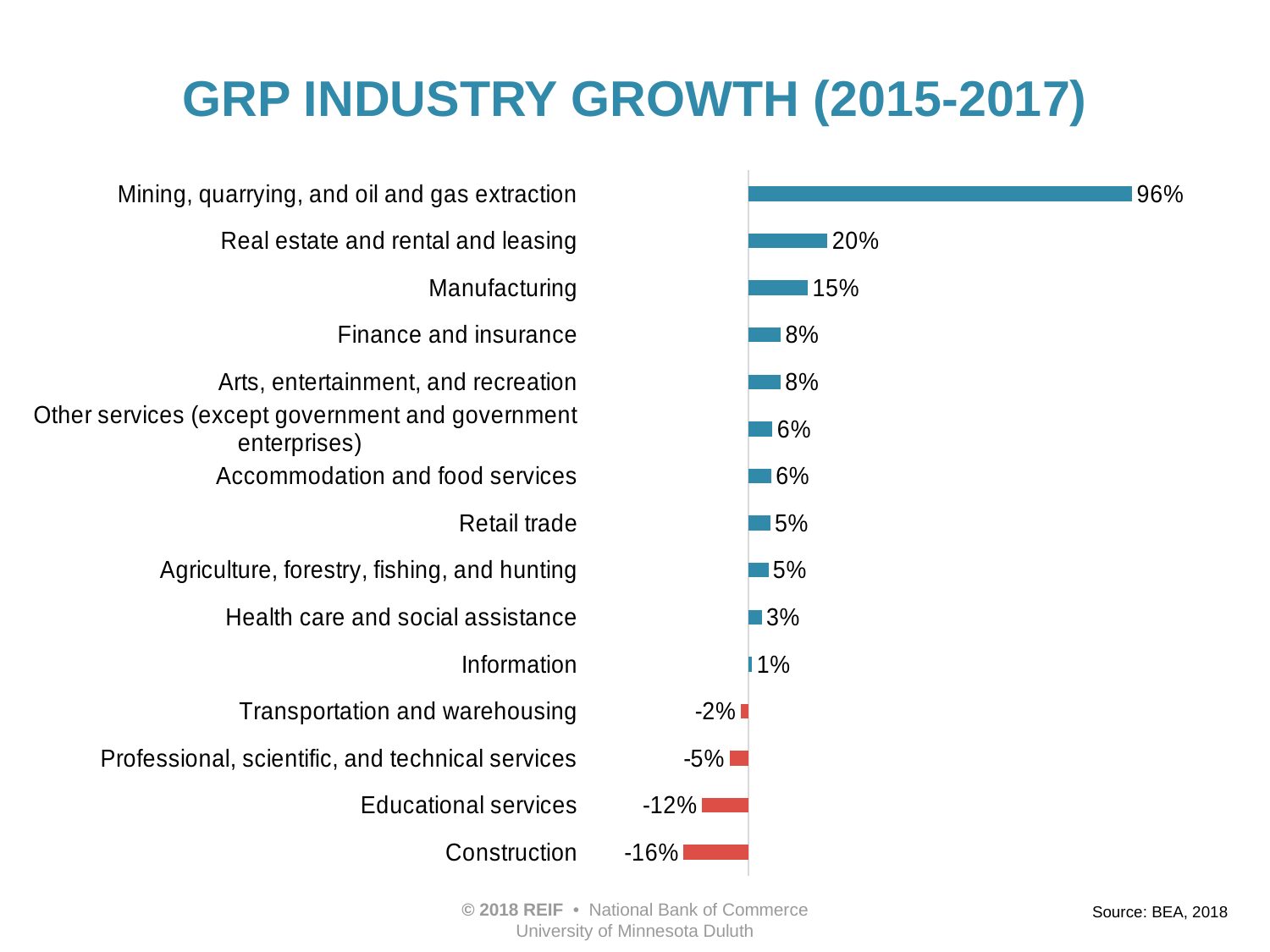
What is the GRP growth value for Construction? -16% What colour are the bars for industries with negative growth? Red How many industries are shown in the chart? 15 What kind of chart is shown on the slide? Bar chart Which industry has the highest GRP growth? Mining, quarrying, and oil and gas extraction What is the title of the chart? GRP INDUSTRY GROWTH (2015-2017) How many industries show negative GRP growth? 4 What is the difference between the growth for Real estate and rental and leasing and the growth for Manufacturing? 5% What is the GRP growth value for Health care and social assistance? 3% Which industry has the lowest GRP growth? Construction What is the GRP growth value for Manufacturing? 15% Which has a larger GRP growth value, Educational services or Professional, scientific, and technical services? Professional, scientific, and technical services